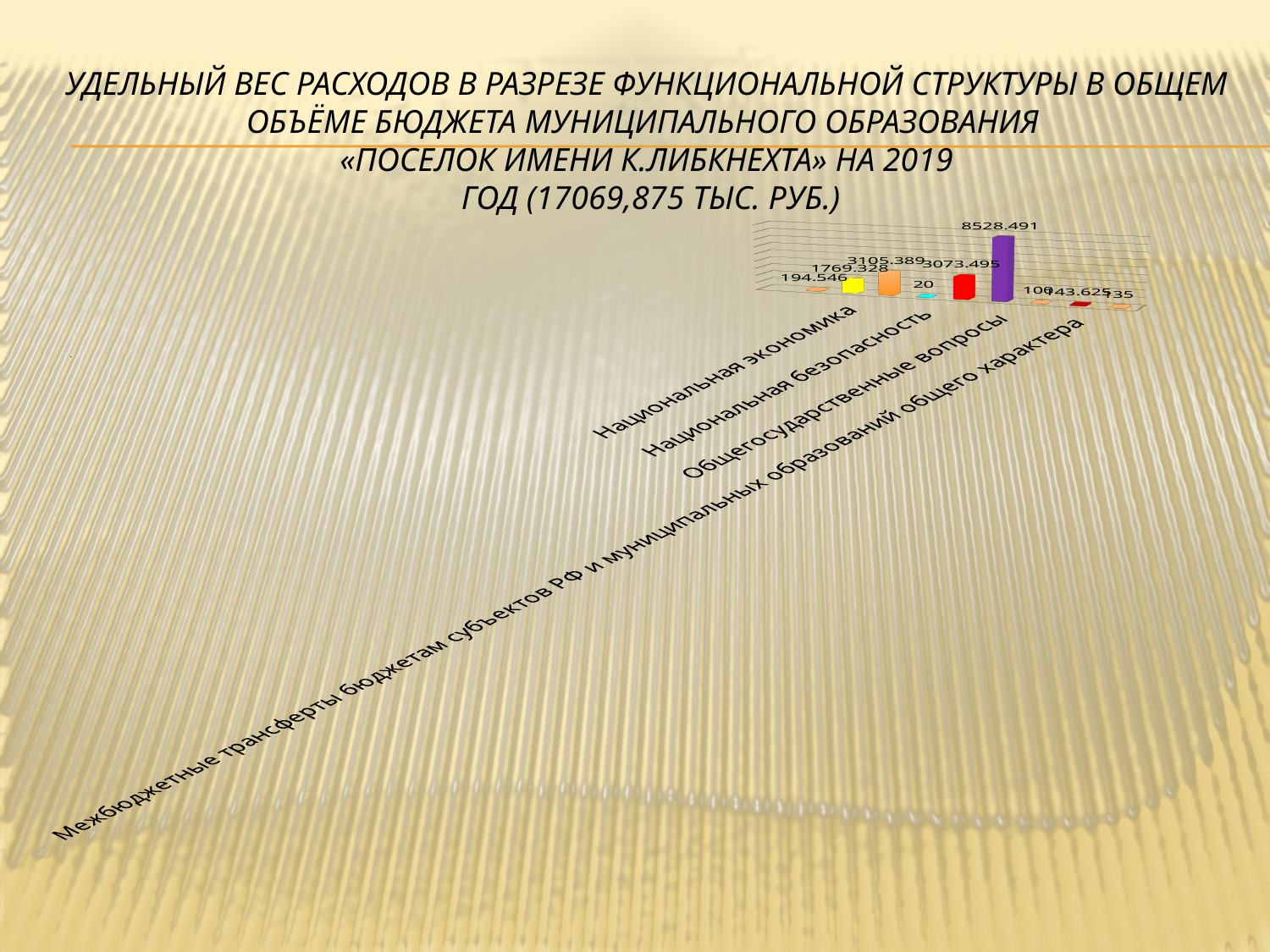
What is the value labelled on the yellow bar? 1769.328 Which is larger on the chart, the bar labelled 1769.328 or the bar labelled 3105.389? 3105.389 What kind of chart is shown on the slide? bar chart What total budget amount is stated in the slide title? 17069,875 тыс. руб. What is the highest value printed on the chart? 8528.491 What is the lowest value printed on the chart? 20 What is the difference between the values 3105.389 and 3073.495 on the chart? 31.894 What is the value labelled on the tall purple bar? 8528.491 How many bars are plotted on the chart? 9 What is the value labelled on the red bar? 3073.495 What is the difference between the values 8528.491 and 3073.495 on the chart? 5454.996